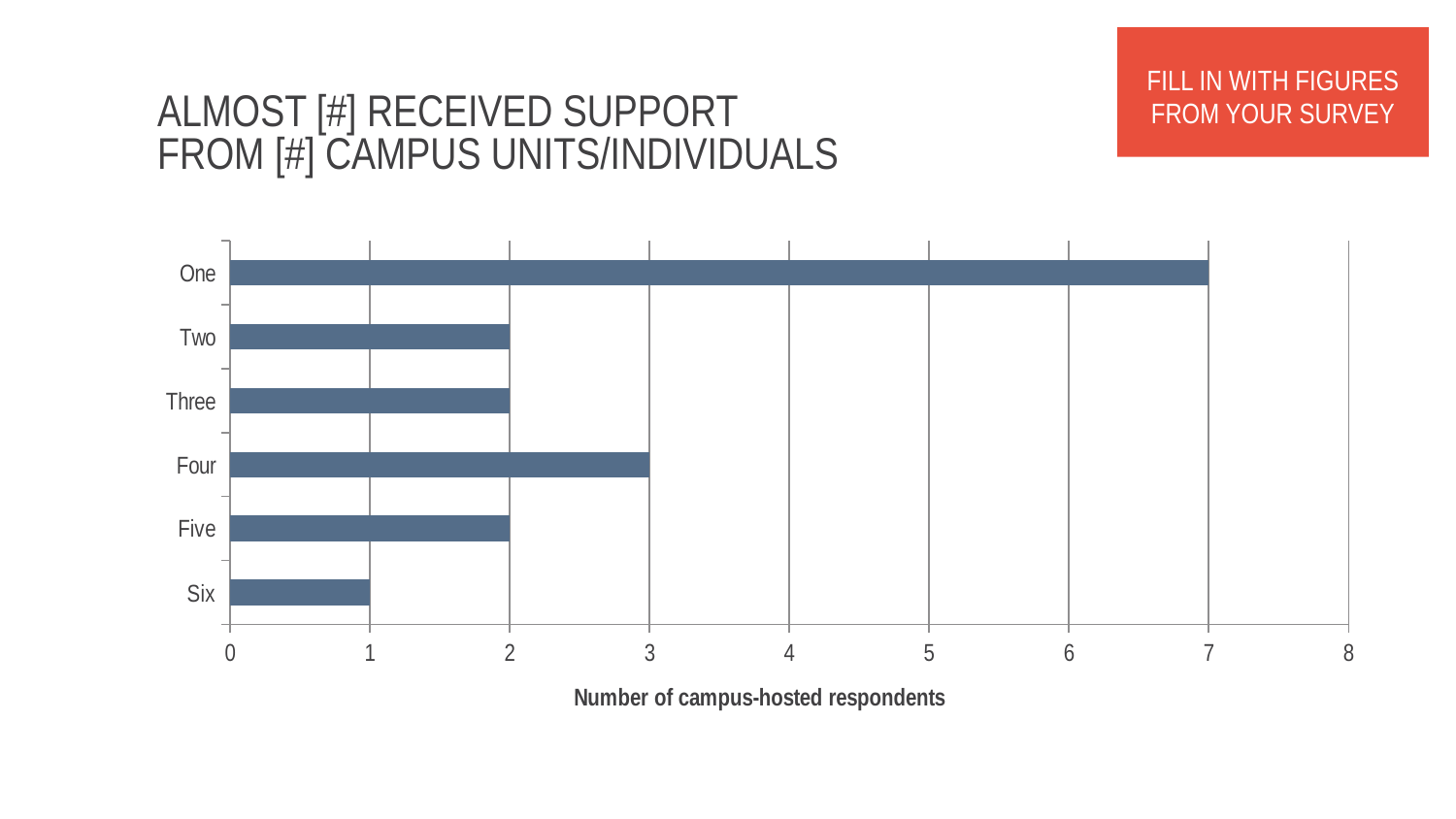
Which has a larger value, "Four" or "Five"? Four What is the number of campus-hosted respondents for the category "Six"? 1 Is the value for "One" greater or less than 5? greater Which category has the lowest number of campus-hosted respondents? Six What kind of chart is shown on the slide? Bar chart What is the number of campus-hosted respondents for the category "Four"? 3 What is the number of campus-hosted respondents for the category "One"? 7 What is the difference between the values for "Four" and "Six"? 2 Which category has the highest number of campus-hosted respondents? One How many categories are shown on the chart? 6 What is the difference between the values for "One" and "Four"? 4 What is the label of the horizontal axis? Number of campus-hosted respondents